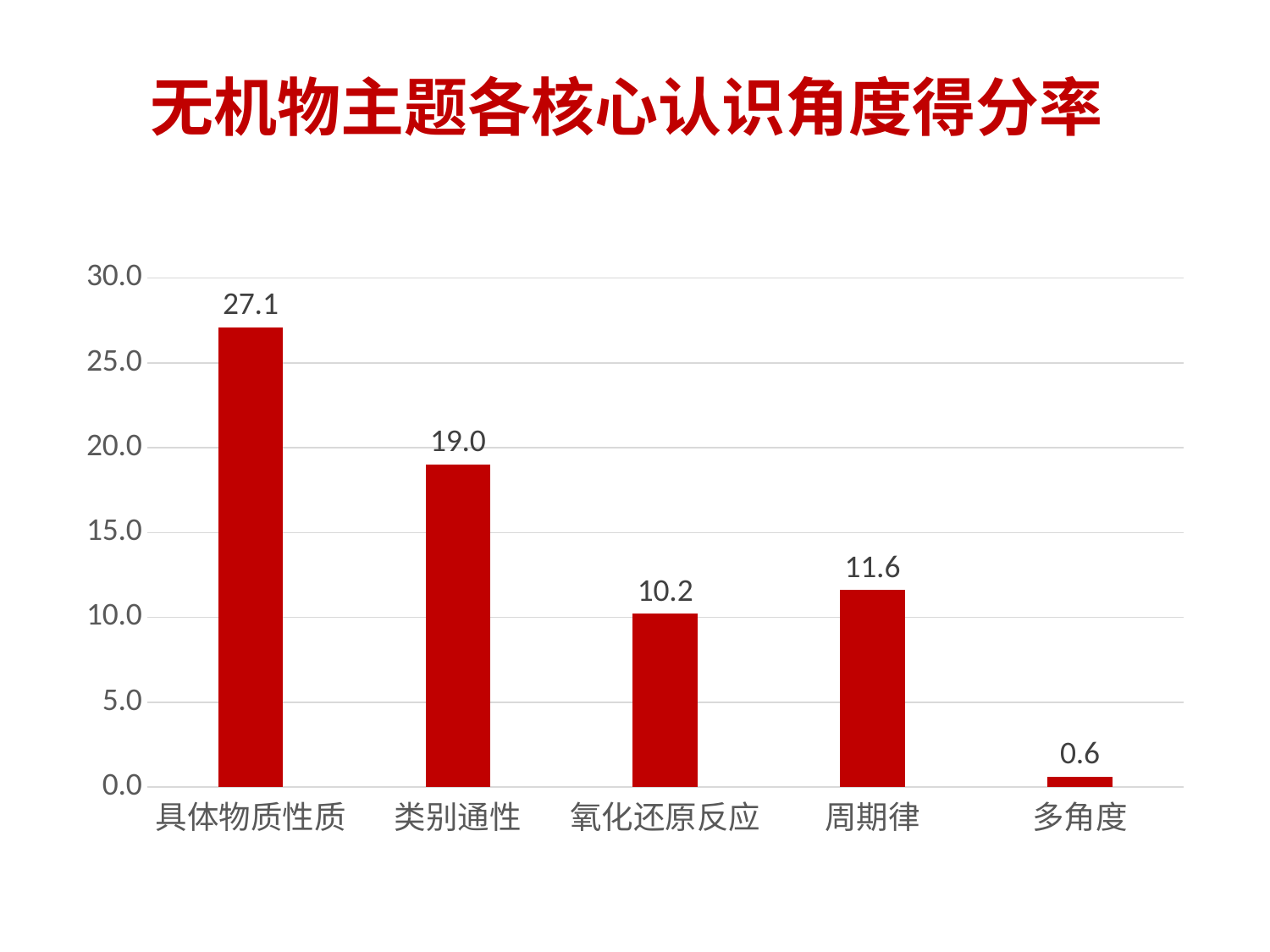
What is the title of the slide? 无机物主题各核心认识角度得分率 Which is larger, the value for 周期律 or the value for 氧化还原反应? 周期律 Which category has the lowest value? 多角度 What is the value for 周期律? 11.6 What is the value for 具体物质性质? 27.1 What is the value for 类别通性? 19.0 What is the value for 氧化还原反应? 10.2 What is the value for 多角度? 0.6 What kind of chart is shown on the slide? bar chart How many categories are shown on the x axis? 5 Which category has the highest value? 具体物质性质 What is the difference between the values for 具体物质性质 and 类别通性? 8.1